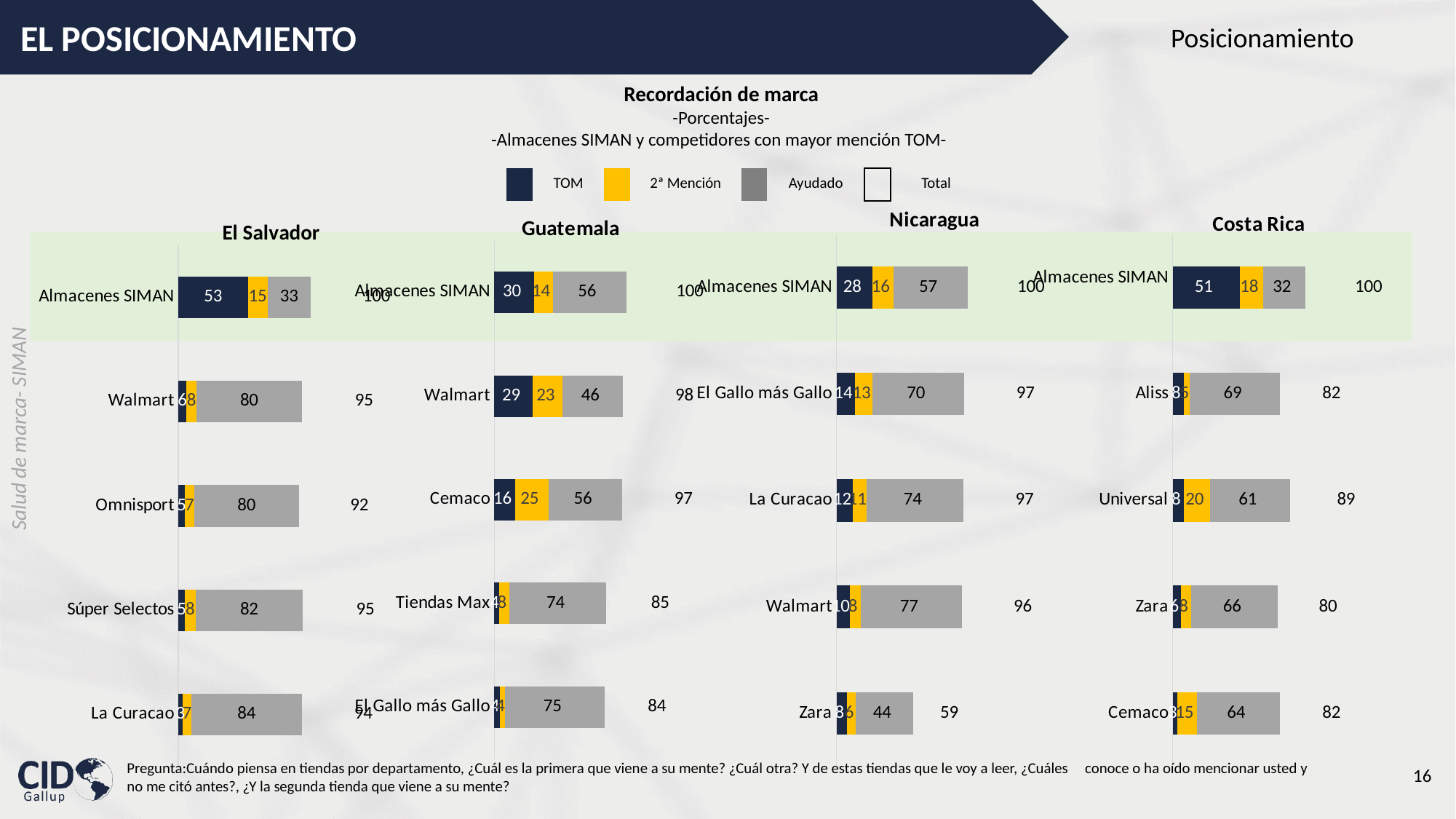
In the Guatemala chart, what is the difference between the Total for Almacenes SIMAN and the Total for El Gallo más Gallo? 16 What kind of chart is used for El Salvador? Stacked bar chart In the Guatemala chart, which has a larger TOM value, Walmart or Cemaco? Walmart How many brands are shown in the Nicaragua chart? 5 In the El Salvador chart, what is the TOM value for Almacenes SIMAN? 53 Which colour represents Ayudado in the legend? Grey In the Nicaragua chart, which brand has the lowest Total? Zara In the Guatemala chart, what is the Ayudado value for Walmart? 46 In the Costa Rica chart, what is the 2ª Mención value for Universal? 20 In the Nicaragua chart, what is the Total for Zara? 59 In the Costa Rica chart, which brand has the highest Total? Almacenes SIMAN How many series does the legend list? 4